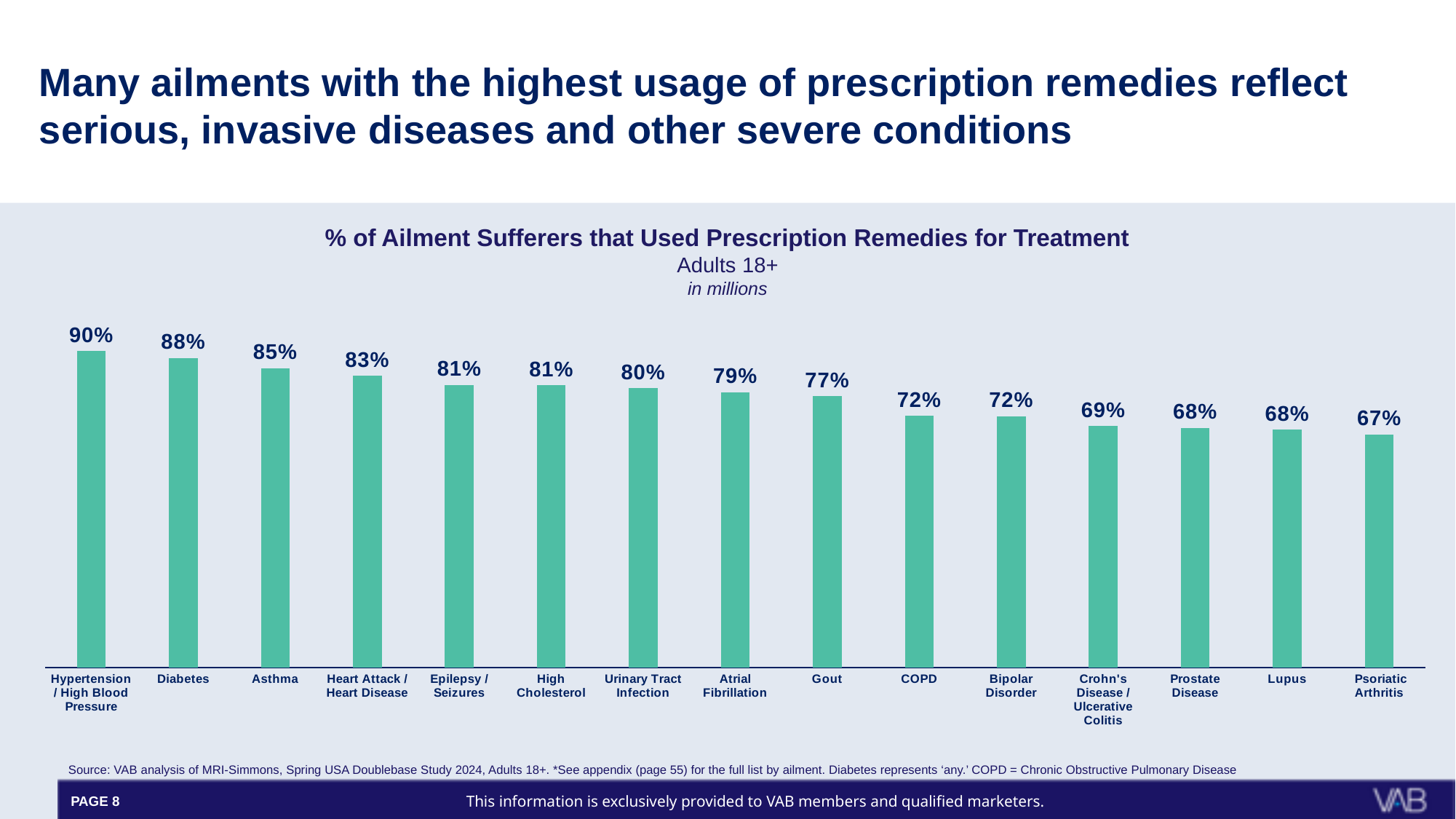
Which ailment has the lowest percentage of sufferers using prescription remedies? Psoriatic Arthritis How many ailments are shown in the chart? 15 Which has a higher value, Heart Attack / Heart Disease or Atrial Fibrillation? Heart Attack / Heart Disease What is the value shown for Gout? 77% What percentage of Diabetes sufferers used prescription remedies for treatment? 88% What is the difference in percentage points between Hypertension / High Blood Pressure and Psoriatic Arthritis? 23 What is the difference in percentage points between Asthma and COPD? 13 What is the value shown for Crohn's Disease / Ulcerative Colitis? 69% What type of chart is shown on the slide? Bar chart Do the values rise or fall moving from left to right across the chart? Fall Which has a higher value, Urinary Tract Infection or Bipolar Disorder? Urinary Tract Infection Which ailment has the highest percentage of sufferers using prescription remedies? Hypertension / High Blood Pressure